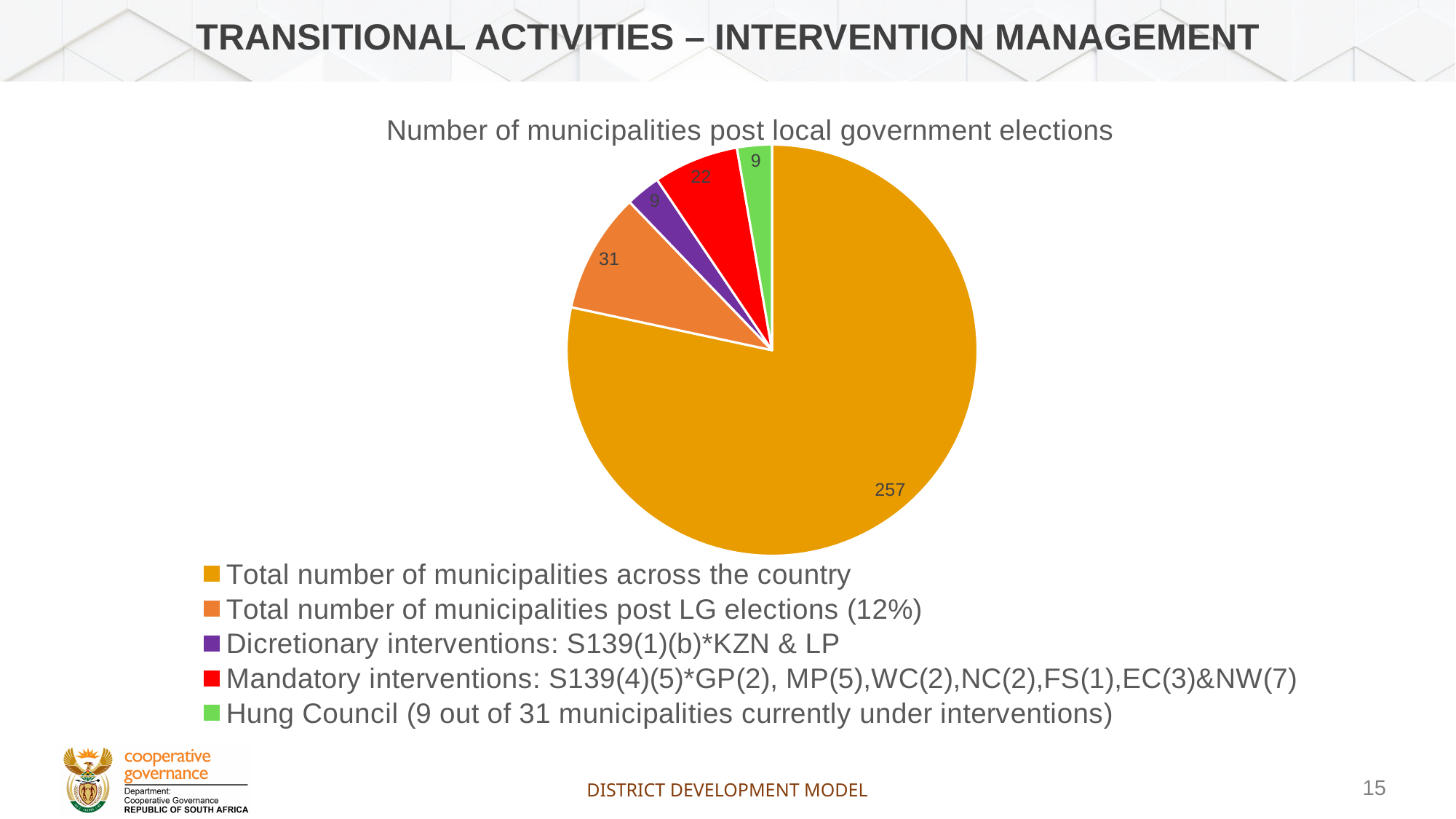
Which is larger: the 'Total number of municipalities post LG elections (12%)' slice or the 'Mandatory interventions' slice? Total number of municipalities post LG elections (12%) What value is shown for the slice 'Total number of municipalities across the country'? 257 What type of chart is shown on the slide? Pie chart What is the difference between the 'Total number of municipalities across the country' slice and the 'Total number of municipalities post LG elections (12%)' slice? 226 How many slices does the pie chart have? 5 What value is shown for the 'Hung Council' slice? 9 What value is shown for the slice 'Total number of municipalities post LG elections (12%)'? 31 What is the title of the chart? Number of municipalities post local government elections What value is shown for the 'Mandatory interventions' slice? 22 Which slice of the pie chart is the largest? Total number of municipalities across the country How many entries does the legend list? 5 What colour is the 'Hung Council' slice in the pie chart? Green